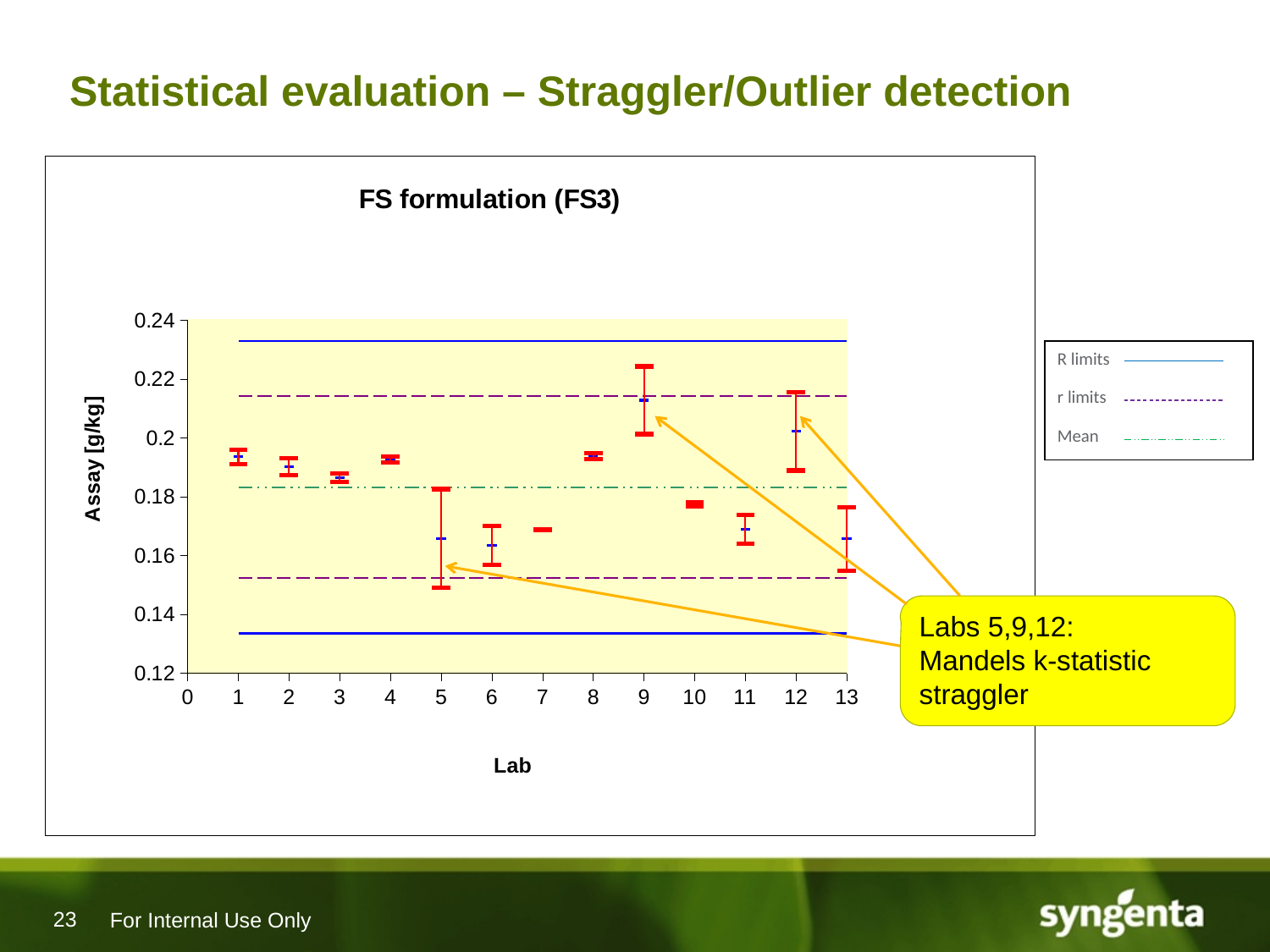
What is the title of the chart? FS formulation (FS3) How many entries does the chart legend list? 3 Is the mean value for Lab 7 greater or less than 0.18? less How many labs are plotted on the x axis of the chart? 13 What is the label of the y axis? Assay [g/kg] Which has the larger mean assay value, Lab 9 or Lab 5? Lab 9 Is the mean value for Lab 9 greater or less than 0.2? greater Is the mean value for Lab 5 greater or less than 0.18? less Which has the larger mean assay value, Lab 1 or Lab 6? Lab 1 Which lab has the highest mean assay value? Lab 9 What kind of chart is shown on the slide? A scatter chart with error bars